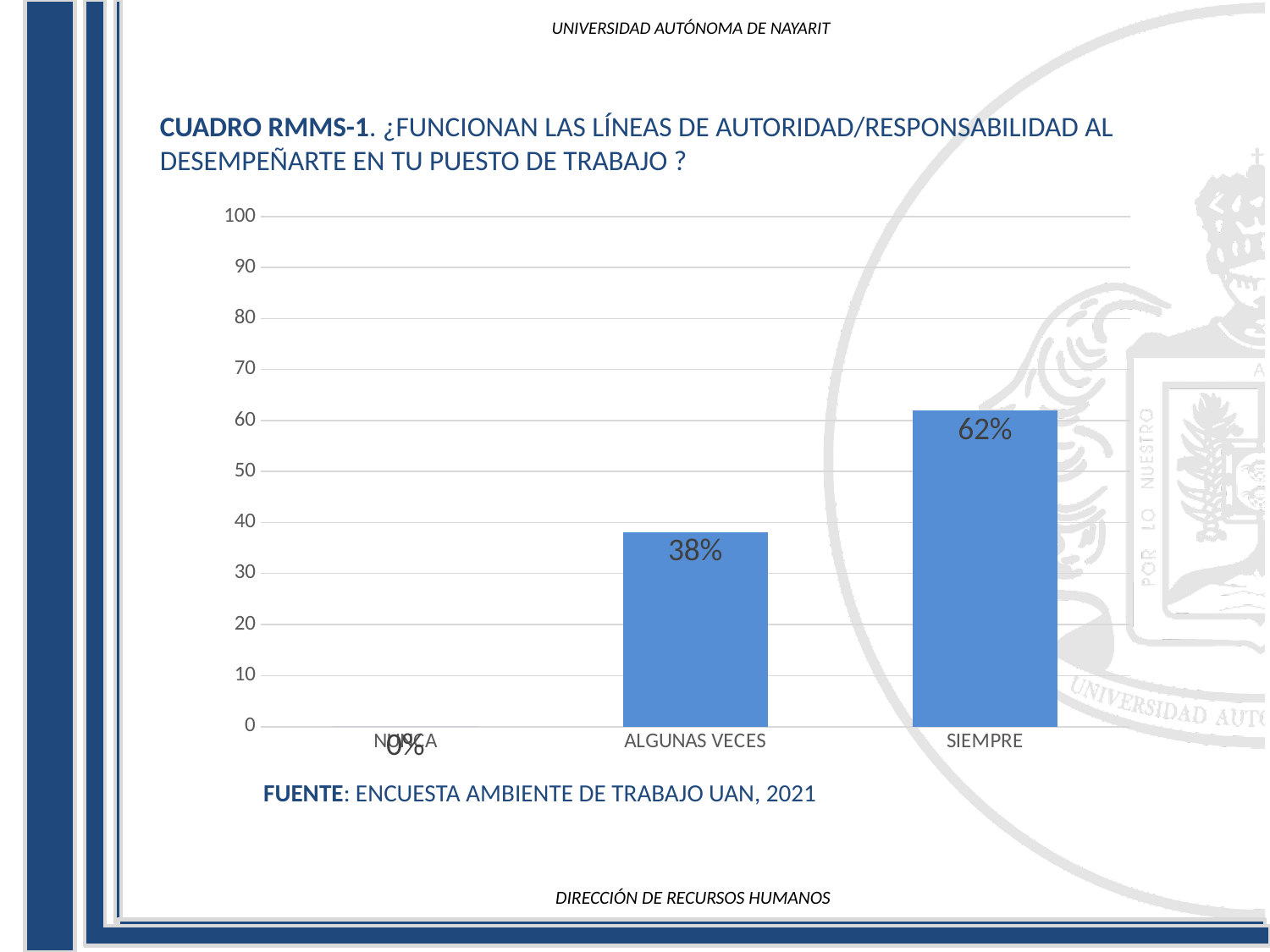
Which is larger, the value for ALGUNAS VECES or the value for SIEMPRE? SIEMPRE What source is cited below the chart? ENCUESTA AMBIENTE DE TRABAJO UAN, 2021 Which category has the highest value? SIEMPRE What is the value for NUNCA? 0% How many categories are shown on the x axis? 3 What is the value for ALGUNAS VECES? 38% Is the value for SIEMPRE greater or less than 50? greater What kind of chart is shown on the slide? bar chart What is the difference between the values for SIEMPRE and ALGUNAS VECES? 24% Is the value for ALGUNAS VECES greater or less than 40? less Which category has the lowest value? NUNCA What is the value for SIEMPRE? 62%